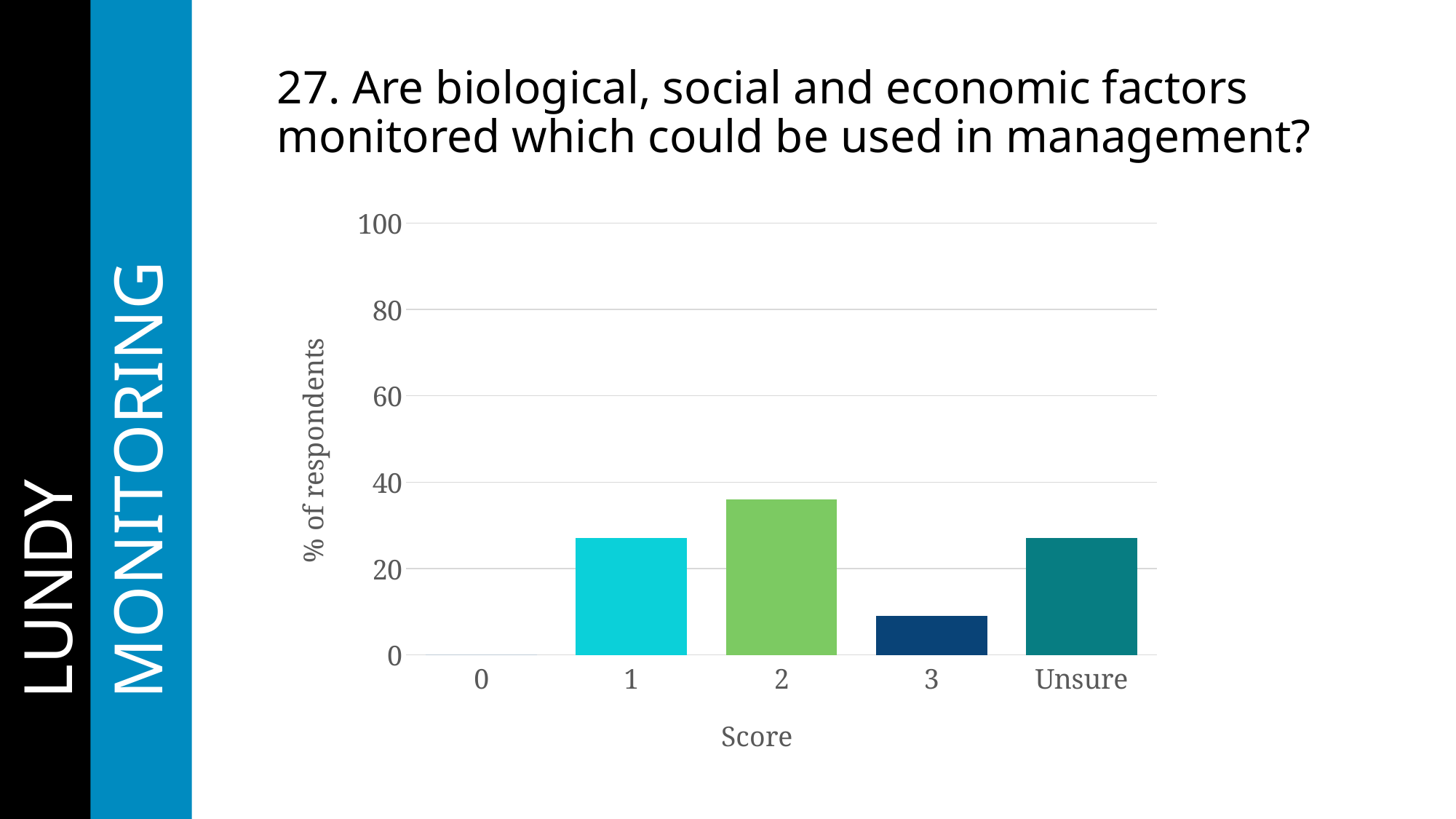
Is the value for score 3 greater or less than 20? less Which is larger, the value for score 2 or the value for score 3? 2 What kind of chart is shown on the slide? Bar chart What is the label on the x axis of the chart? Score Is the value for Unsure greater or less than 40? less Which score category has the lowest percentage of respondents? 0 Is the value for score 2 greater or less than 20? greater Which score category has the highest percentage of respondents? 2 How many categories are shown on the x axis of the chart? 5 What is the label on the y axis of the chart? % of respondents